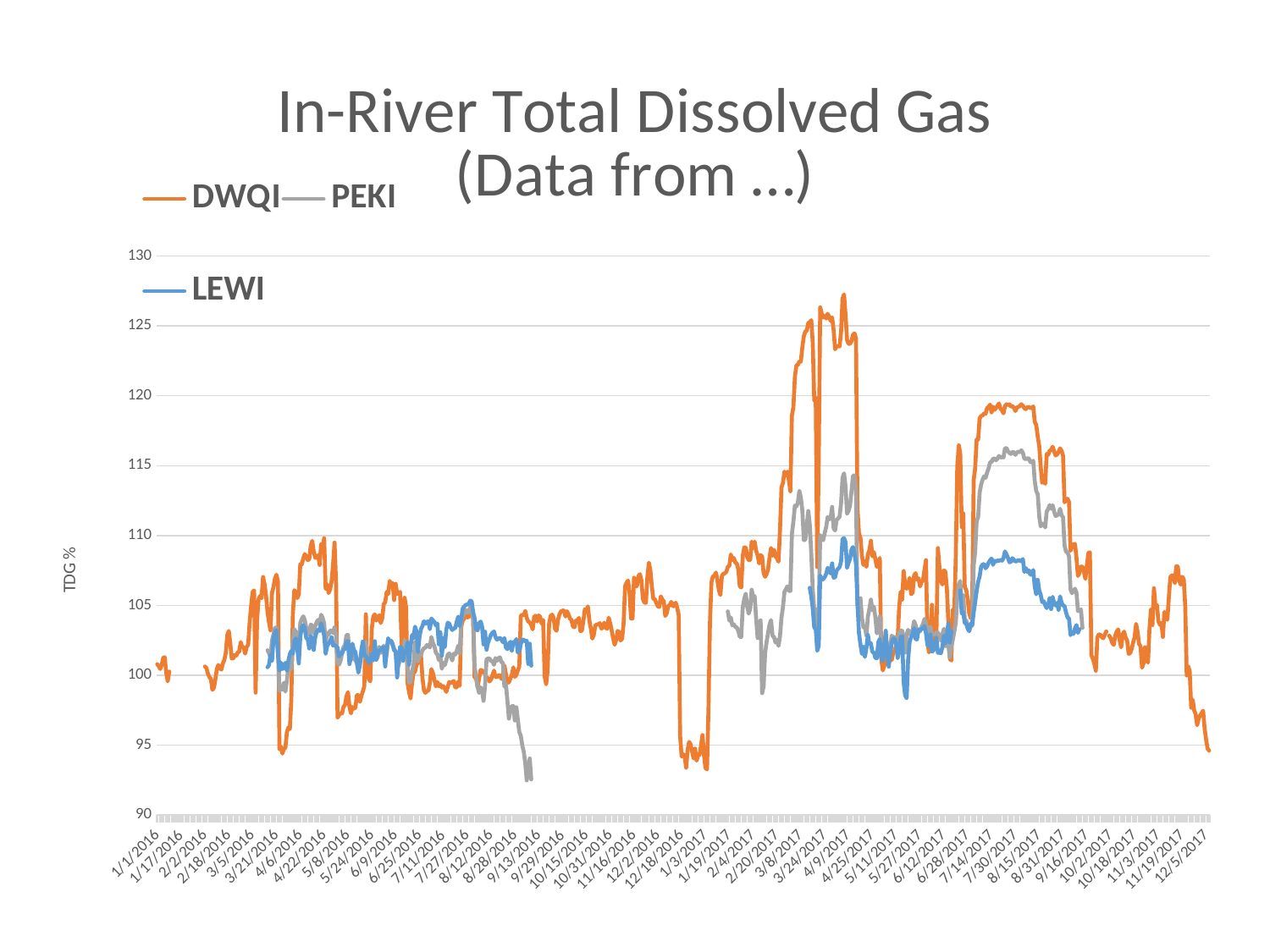
Is the value of DWQI around 7/30/2017 greater or less than 115? greater Which series has the lowest peak value on the chart? LEWI Which series reaches the highest value on the chart? DWQI What is the title of the chart? In-River Total Dissolved Gas (Data from ...) What is the label on the vertical axis? TDG % Is the peak value of LEWI around 7/30/2017 greater or less than 110? less Around 3/24/2017, which series has the larger value, DWQI or PEKI? DWQI Does the DWQI series rise or fall between 11/19/2017 and 12/5/2017? fall Is the peak value of DWQI around 4/9/2017 greater or less than 125? greater How many series does the legend list? 3 What kind of chart is shown on the slide? line chart Around 7/30/2017, which series has the larger value, LEWI or PEKI? PEKI